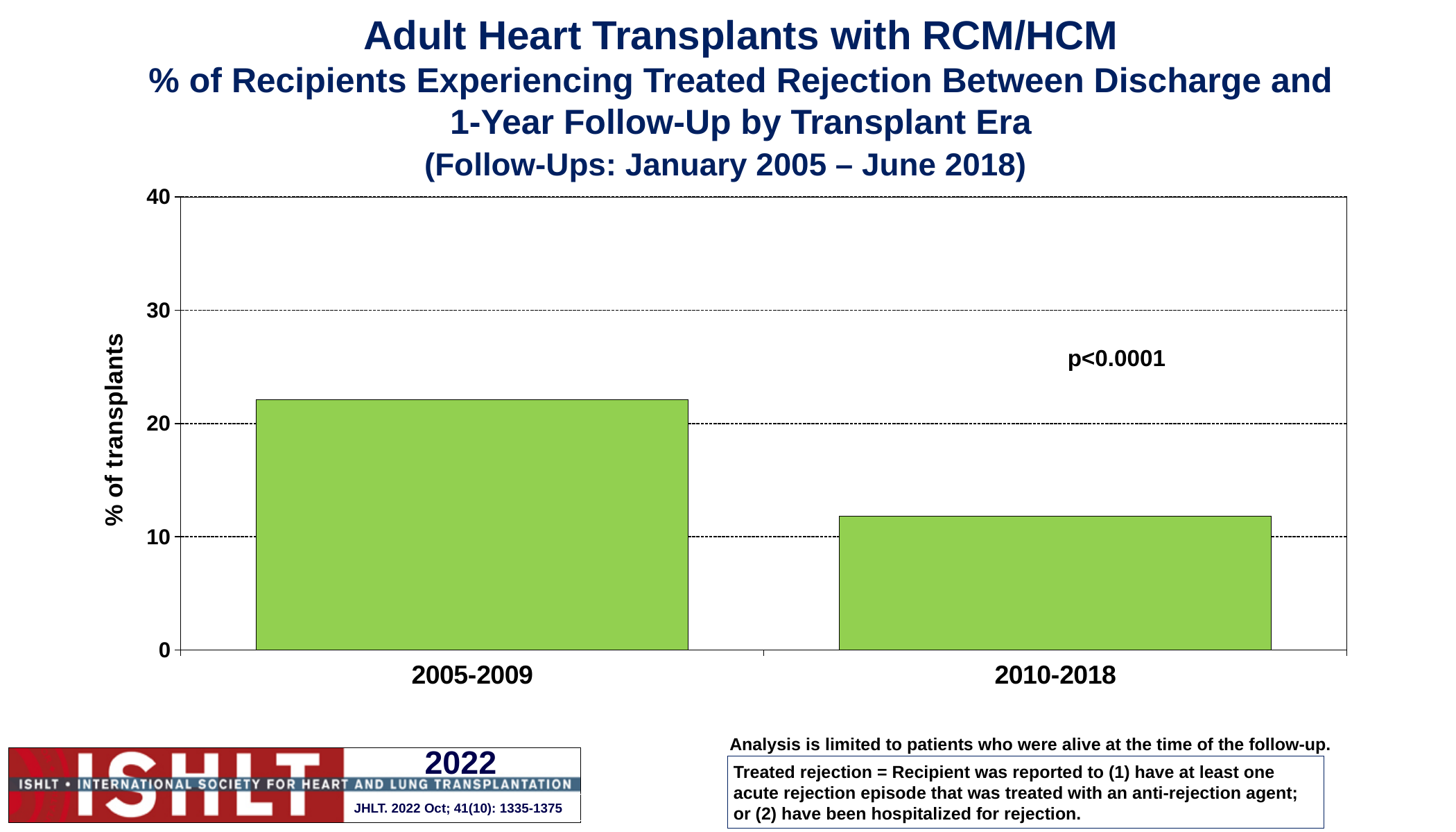
Is the value for 2010-2018 greater or less than 10? greater What p-value is printed on the chart? p<0.0001 What is the label of the y axis? % of transplants Which era has a larger value, 2005-2009 or 2010-2018? 2005-2009 What kind of chart is shown on the slide? bar chart Is the value for 2005-2009 greater or less than 30? less Which transplant era has the highest % of transplants with treated rejection? 2005-2009 Do the values rise or fall from the 2005-2009 era to the 2010-2018 era? fall How many transplant era categories are shown on the x axis? 2 Is the value for 2010-2018 greater or less than 20? less Which transplant era has the lowest % of transplants with treated rejection? 2010-2018